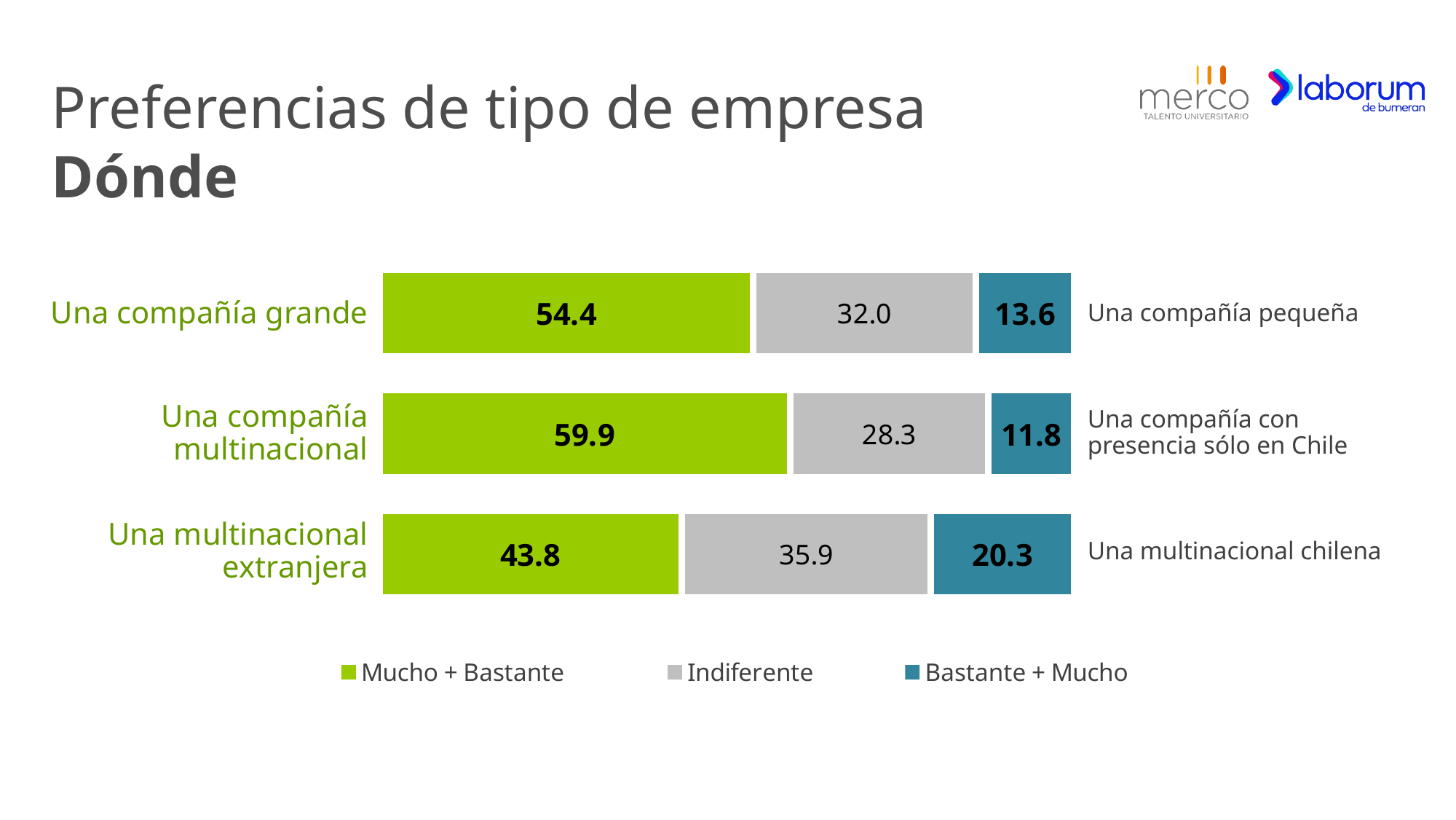
What is the total of the stacked bar for "Una compañía grande"? 100.0 What is the "Mucho + Bastante" value for "Una compañía grande"? 54.4 Which colour represents the "Indiferente" series? Grey How many series does the legend list? 3 How many rows (bars) does the chart show? 3 Which row has the highest "Mucho + Bastante" value? Una compañía multinacional What is the "Bastante + Mucho" value in the row for "Una multinacional extranjera" / "Una multinacional chilena"? 20.3 What kind of chart is shown on the slide? Stacked bar chart What is the "Indiferente" value for "Una compañía multinacional"? 28.3 What is the difference between the "Mucho + Bastante" values for "Una compañía multinacional" and "Una multinacional extranjera"? 16.1 Which is larger: the "Indiferente" value for "Una compañía grande" or for "Una multinacional extranjera"? Una multinacional extranjera Which row has the lowest "Bastante + Mucho" value? Una compañía con presencia sólo en Chile